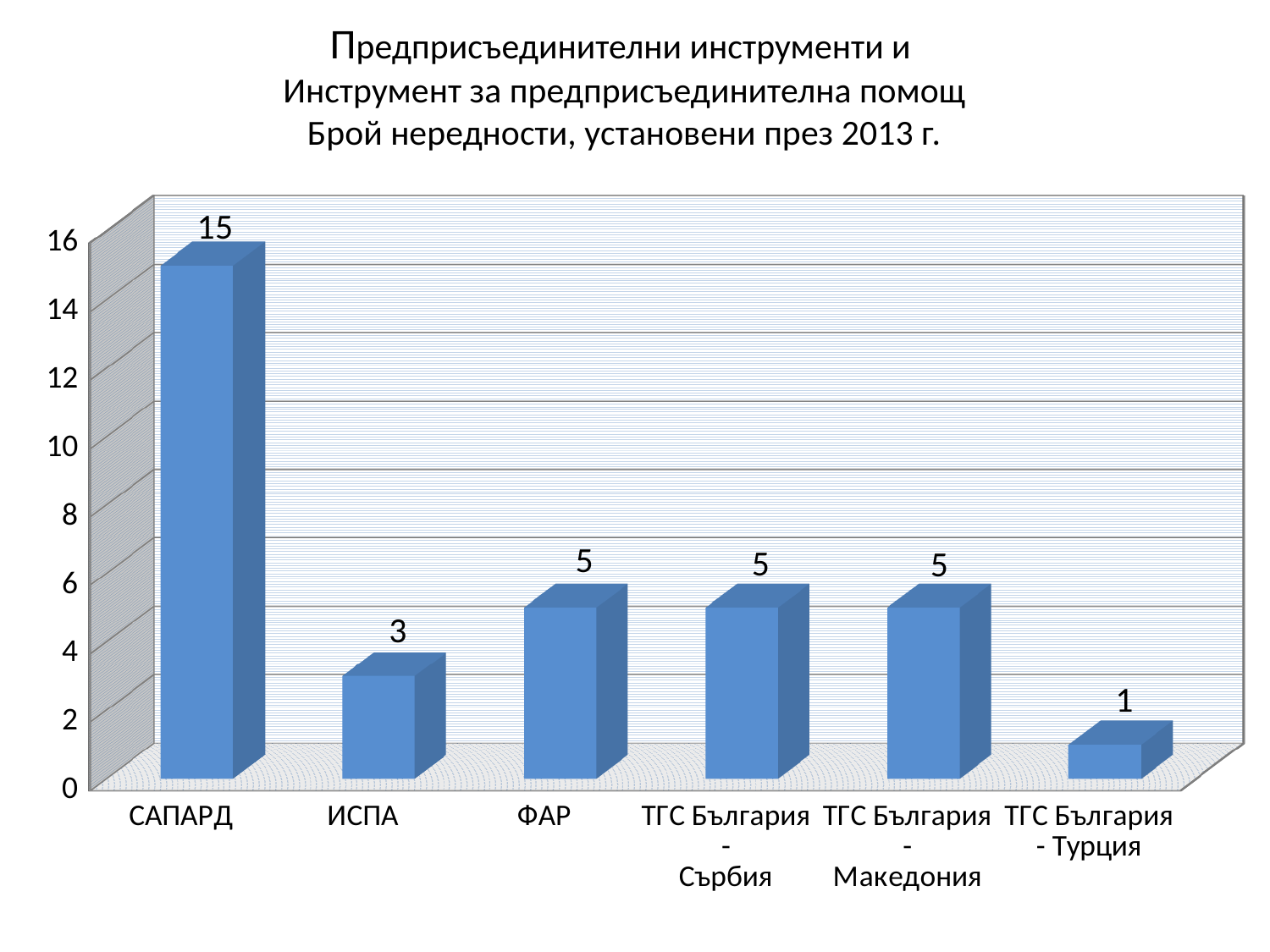
What is the difference between the values for ФАР and ТГС България - Турция? 4 What kind of chart is shown on the slide? bar chart What is the value for ТГС България - Турция? 1 Which is larger, the value for ИСПА or the value for ТГС България - Сърбия? ТГС България - Сърбия What is the value for САПАРД? 15 What is the value for ФАР? 5 How many categories are shown on the x axis? 6 What is the value for ИСПА? 3 Which year do the irregularities in the chart title refer to? 2013 Which category has the lowest value? ТГС България - Турция Which category has the highest value? САПАРД What is the difference between the values for САПАРД and ИСПА? 12